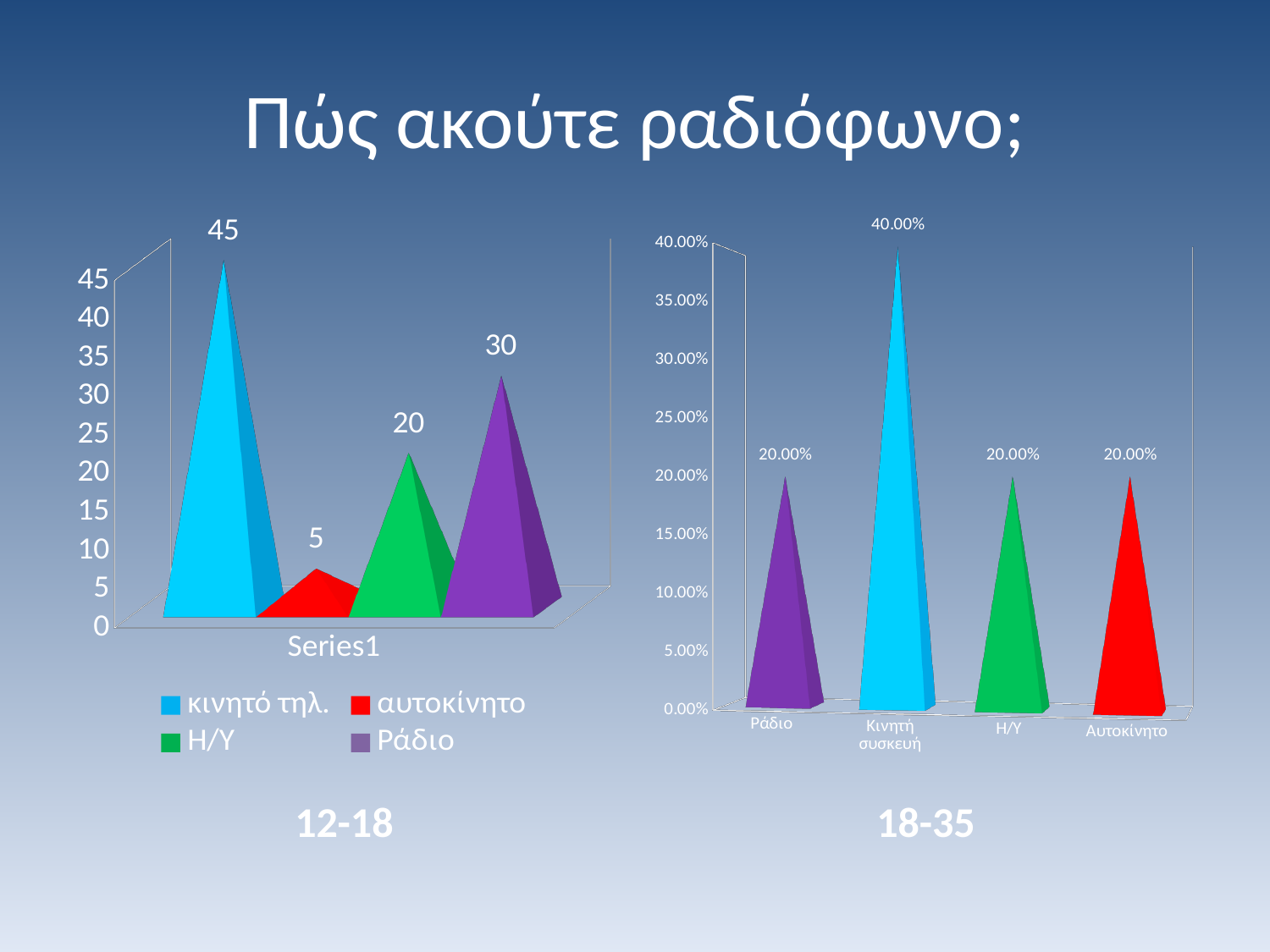
In the 18-35 chart, what is the value for Κινητή συσκευή? 40.00% In the 12-18 chart, what is the value for αυτοκίνητο? 5 In the 12-18 chart, which series has the lowest value? αυτοκίνητο In the 18-35 chart, which category has the highest value? Κινητή συσκευή What is the title of the slide above the two charts? Πώς ακούτε ραδιόφωνο; In the 12-18 chart, which is larger, the value for Η/Υ or the value for Ράδιο? Ράδιο How many categories are shown on the x axis of the 18-35 chart? 4 In the 18-35 chart, what is the value for Αυτοκίνητο? 20.00% How many series does the legend of the 12-18 chart list? 4 In the 12-18 chart, what is the difference between the values for κινητό τηλ. and Ράδιο? 15 In the 12-18 chart, what is the value for κινητό τηλ.? 45 In the 12-18 chart, what is the value for Ράδιο? 30